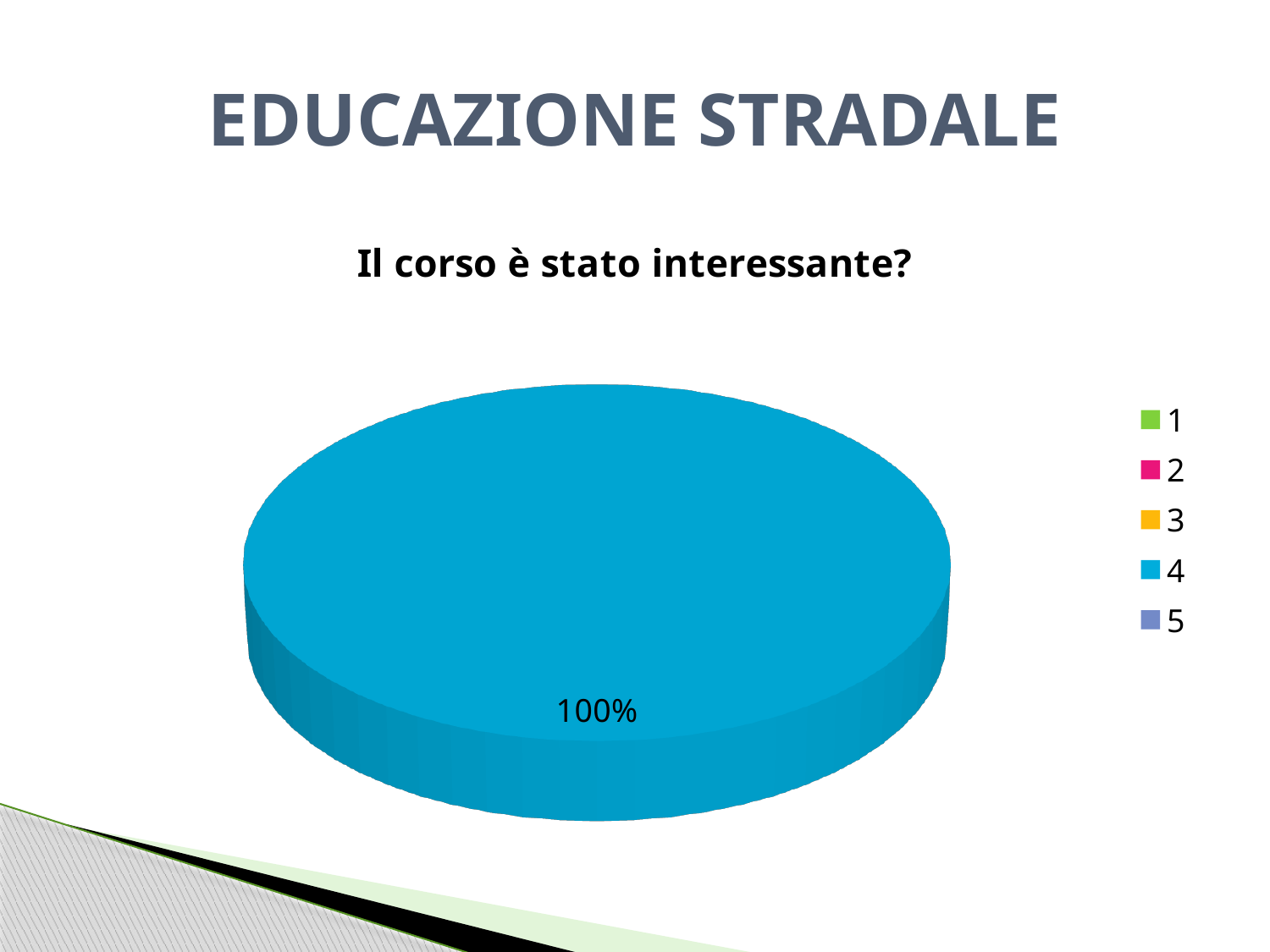
What share of the pie does category 4 take? 100% How many entries does the legend list? 5 What is the title of the chart? Il corso è stato interessante? How many visible slices does the pie have? 1 What kind of chart is shown on the slide? pie chart Which category has the largest share of the pie? 4 What is the only percentage label printed on the pie? 100% Which legend entry corresponds to the blue slice that fills the whole pie? 4